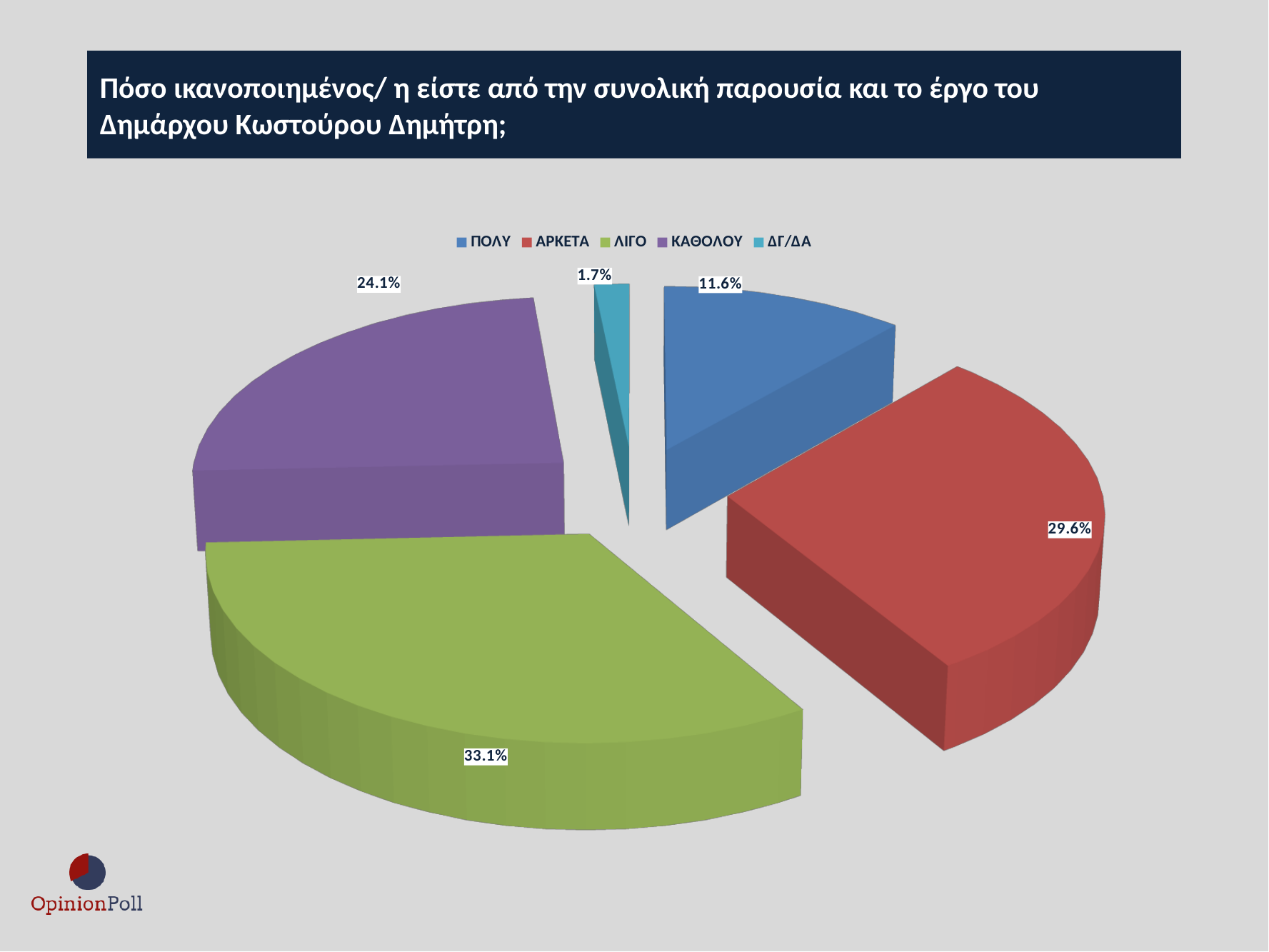
Which category has the smallest share of the pie? ΔΓ/ΔΑ What is the value for ΔΓ/ΔΑ? 1.7% What is the value for ΚΑΘΟΛΟΥ? 24.1% What is the value for ΛΙΓΟ? 33.1% How many categories does the legend list? 5 Which is larger, the value for ΚΑΘΟΛΟΥ or the value for ΠΟΛΥ? ΚΑΘΟΛΟΥ Which category has the largest share of the pie? ΛΙΓΟ What is the value for ΠΟΛΥ? 11.6% What is the value for ΑΡΚΕΤΑ? 29.6% What is the difference between the values for ΛΙΓΟ and ΑΡΚΕΤΑ? 3.5% What kind of chart is shown on the slide? Pie chart What colour is the slice for ΑΡΚΕΤΑ? Red